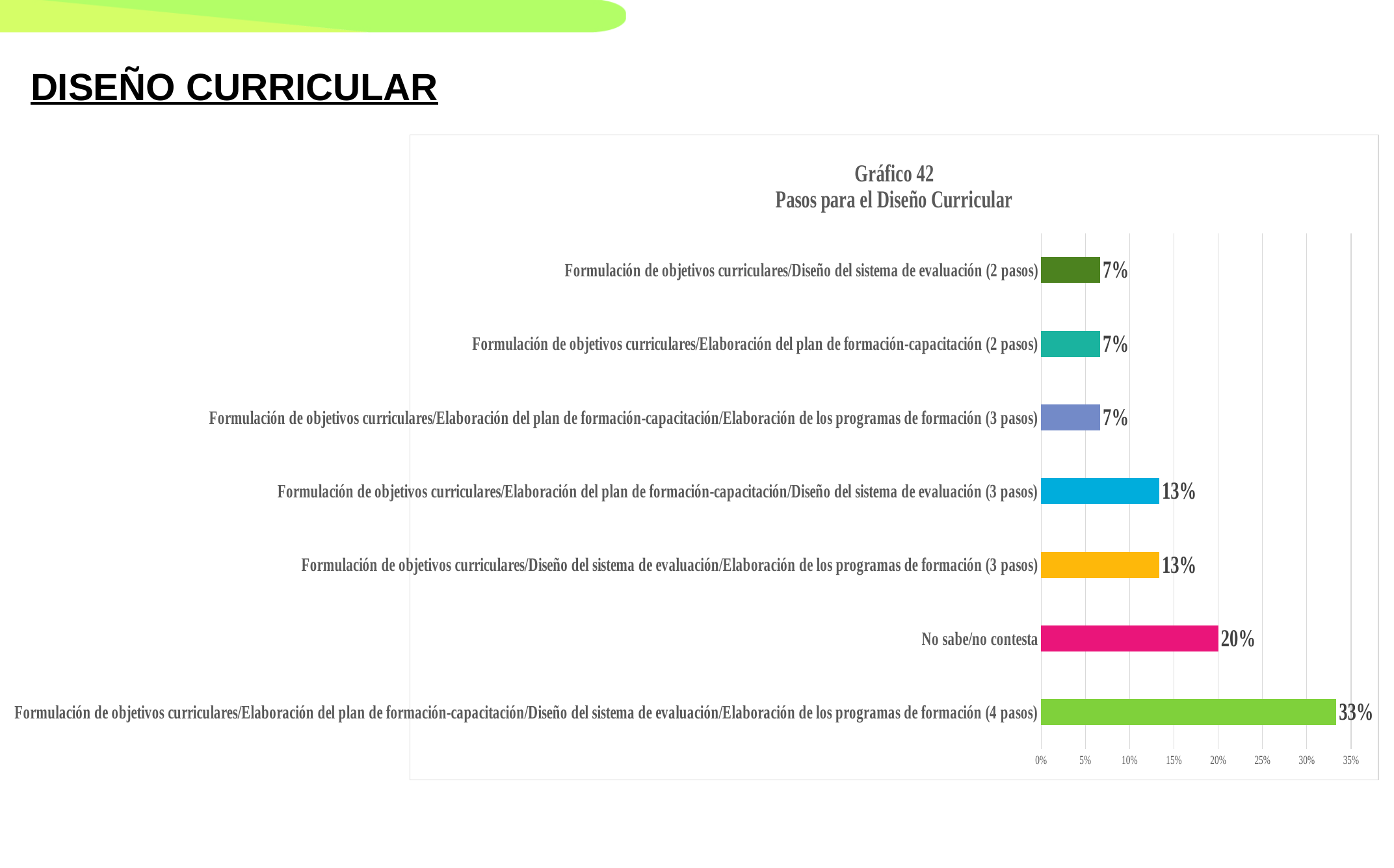
How many categories are shown in the chart? 7 What is the value for "Formulación de objetivos curriculares/Diseño del sistema de evaluación (2 pasos)"? 7% Which is larger: the value for "No sabe/no contesta" or the value for "Formulación de objetivos curriculares/Elaboración del plan de formación-capacitación (2 pasos)"? No sabe/no contesta What is the value for "No sabe/no contesta"? 20% Which category has the highest value? Formulación de objetivos curriculares/Elaboración del plan de formación-capacitación/Diseño del sistema de evaluación/Elaboración de los programas de formación (4 pasos) What is the value for "Formulación de objetivos curriculares/Elaboración del plan de formación-capacitación/Diseño del sistema de evaluación (3 pasos)"? 13% Is the value for the 4 pasos category greater or less than 30%? greater What is the difference between the value for "No sabe/no contesta" and the value for "Formulación de objetivos curriculares/Diseño del sistema de evaluación/Elaboración de los programas de formación (3 pasos)"? 7% What is the value for the 4 pasos category (Formulación de objetivos curriculares/Elaboración del plan de formación-capacitación/Diseño del sistema de evaluación/Elaboración de los programas de formación)? 33% What is the difference between the value for the 4 pasos category and the value for "No sabe/no contesta"? 13% What kind of chart is shown on the slide? Bar chart What is the title of the chart? Gráfico 42 Pasos para el Diseño Curricular